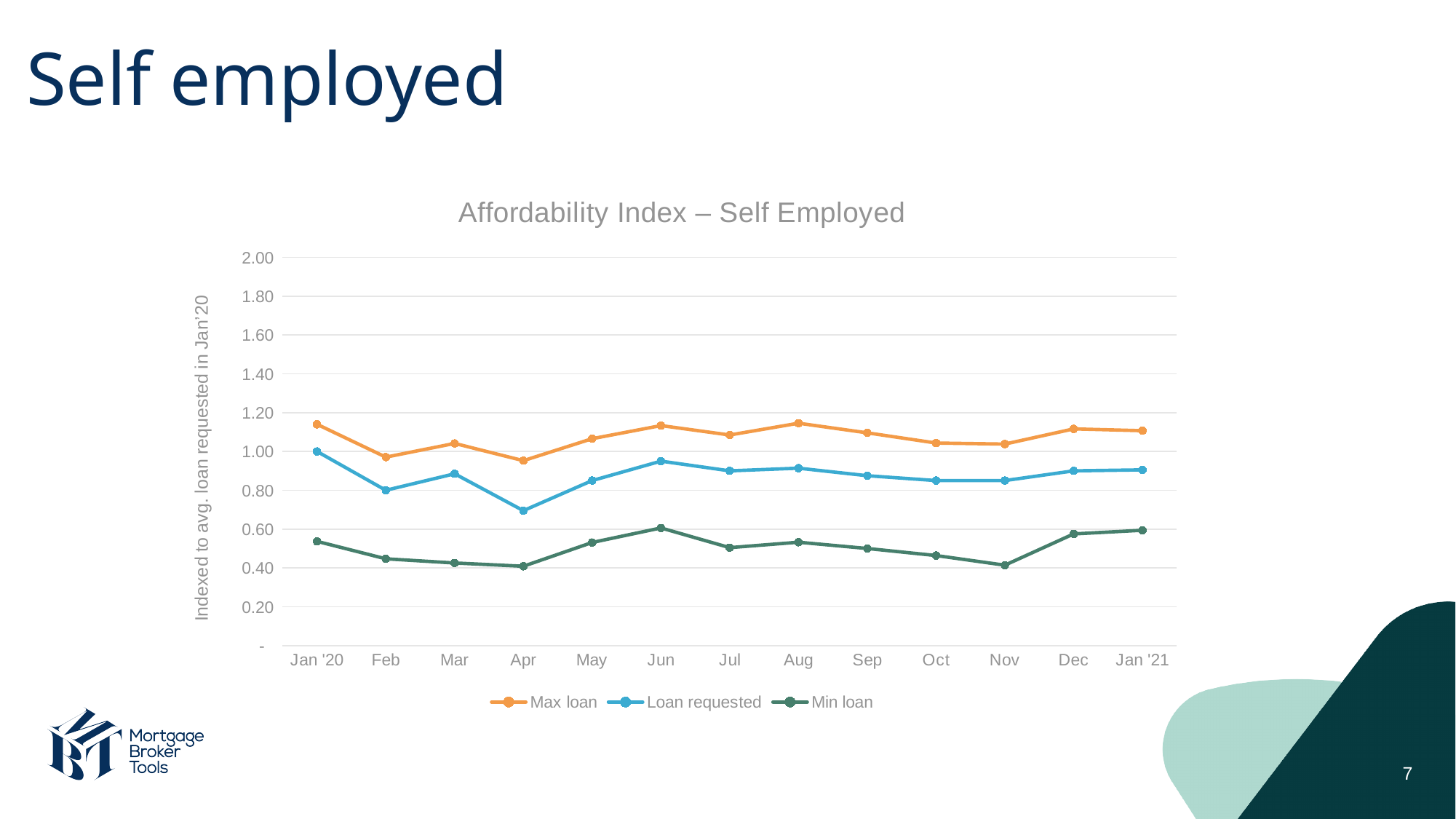
In which month is Max loan at its lowest? Apr Does Loan requested rise or fall from Jan '20 to Apr? fall Is the value for Loan requested in Apr greater or less than 0.80? less Is the value for Max loan in Jan '20 greater or less than 1.00? greater Is the value for Min loan in Apr greater or less than 0.60? less In which month is Loan requested at its lowest? Apr What is the value of Loan requested in Jan '20? 1.00 What kind of chart is shown on the slide? line chart How many months are plotted along the x axis? 13 Which is larger for Max loan: Jan '20 or Feb? Jan '20 How many series does the legend list? 3 What is the title of the chart? Affordability Index – Self Employed